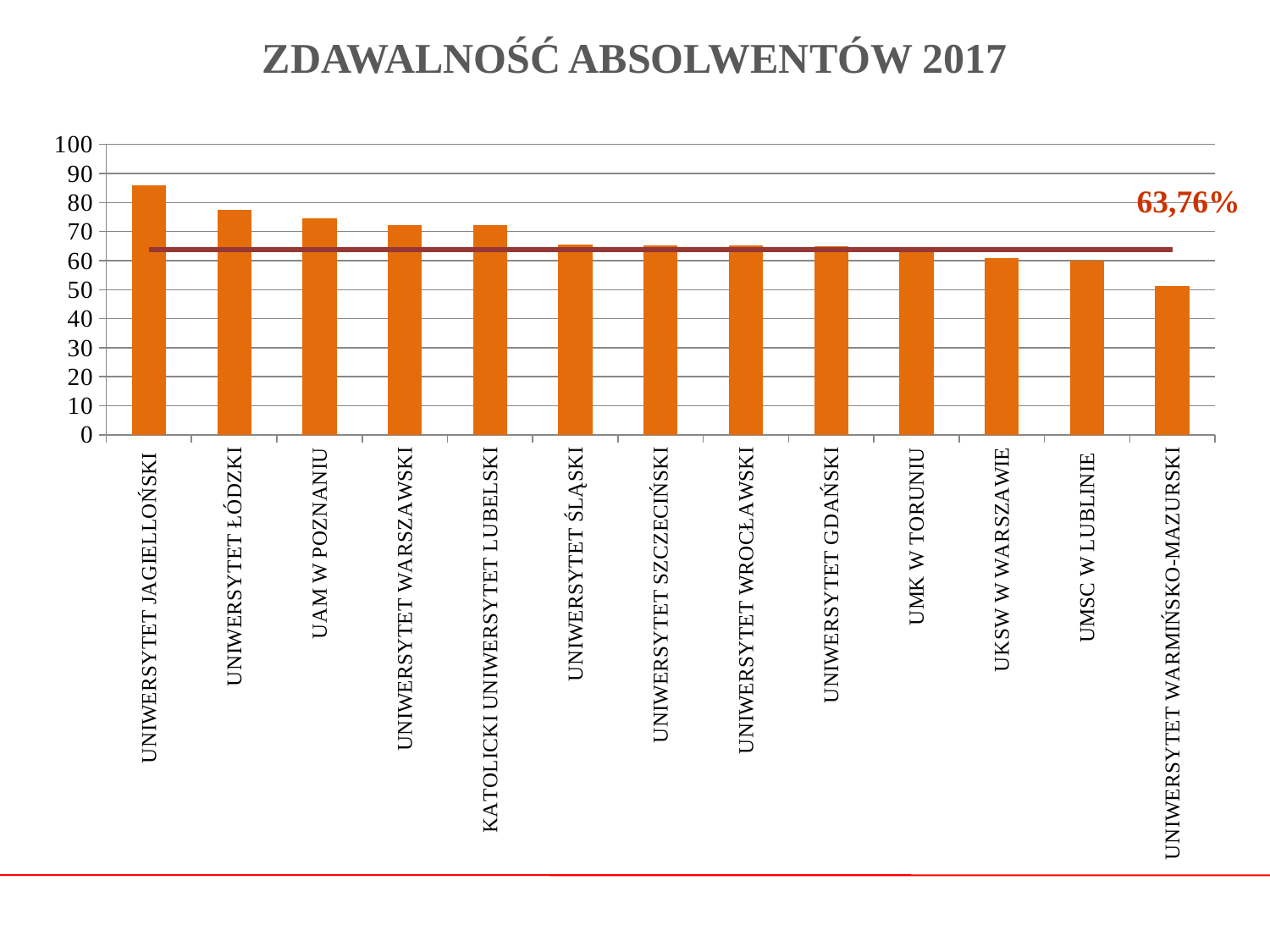
Is the value for UNIWERSYTET JAGIELLOŃSKI greater or less than 80? greater Which is larger, the value for UAM W POZNANIU or the value for UMSC W LUBLINIE? UAM W POZNANIU Is the value for UNIWERSYTET WARMIŃSKO-MAZURSKI greater or less than 60? less What kind of chart is shown on the slide? bar chart Which university has the lowest bar in the chart? UNIWERSYTET WARMIŃSKO-MAZURSKI Which university has the highest bar in the chart? UNIWERSYTET JAGIELLOŃSKI Is the value for UKSW W WARSZAWIE greater or less than 70? less Do the bar values generally rise or fall from left to right along the x axis? fall What value is printed next to the horizontal line drawn across the chart? 63,76% Which is larger, the value for UNIWERSYTET JAGIELLOŃSKI or the value for UNIWERSYTET ŁÓDZKI? UNIWERSYTET JAGIELLOŃSKI How many universities are shown on the x axis of the chart? 13